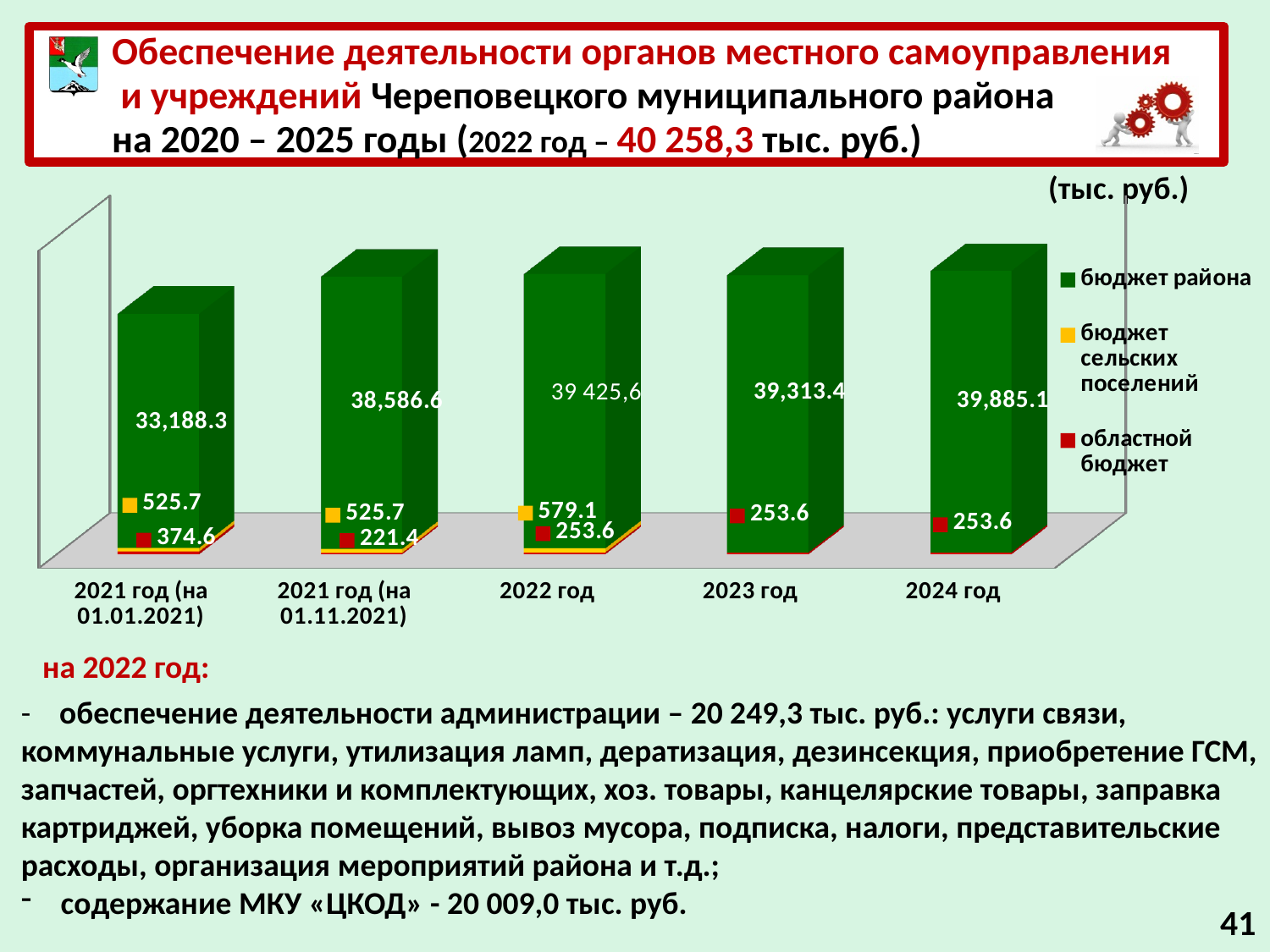
What is the value of 'бюджет сельских поселений' for '2022 год'? 579.1 What is the value of 'бюджет района' for '2022 год'? 39 425,6 Which is larger: the 'областной бюджет' value for '2021 год (на 01.01.2021)' or for '2021 год (на 01.11.2021)'? 2021 год (на 01.01.2021) What is the total of the stacked bar for '2022 год'? 40 258,3 Which category has the highest value for 'бюджет района'? 2024 год How many series does the chart legend list? 3 How many categories are shown along the x axis of the chart? 5 Which category has the lowest value for 'бюджет района'? 2021 год (на 01.01.2021) What is the difference between the 'бюджет района' values for '2024 год' and '2023 год'? 571.7 What type of chart is shown on the slide? stacked bar chart Which series is shown in green in the chart? бюджет района What is the value of 'областной бюджет' for '2021 год (на 01.01.2021)'? 374.6